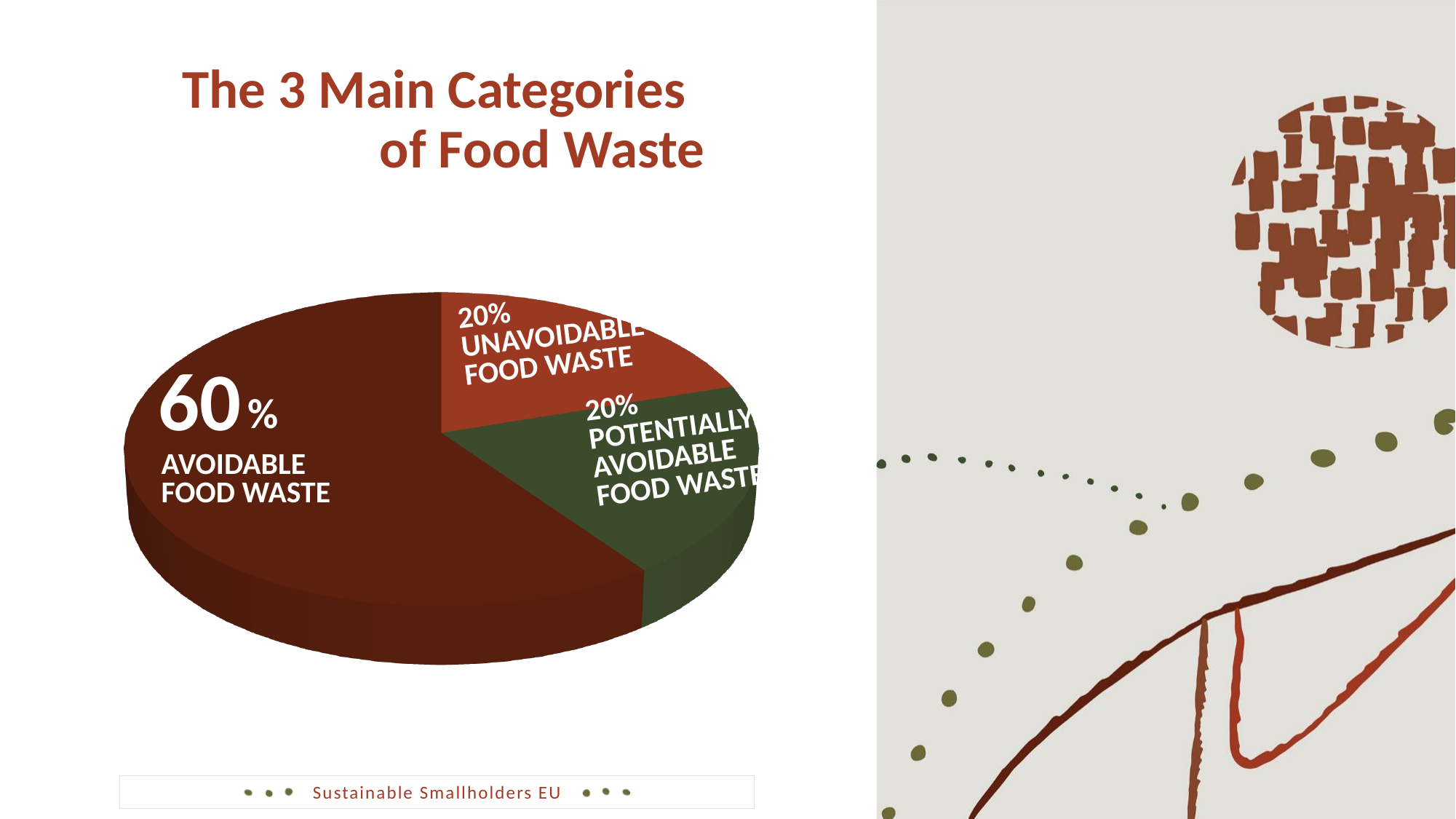
What is the title of the slide containing the pie chart? The 3 Main Categories of Food Waste What is the combined share of Unavoidable Food Waste and Potentially Avoidable Food Waste? 40% What colour is the slice for Potentially Avoidable Food Waste? dark green How many slices does the pie chart have? 3 What is the difference in percentage points between Avoidable Food Waste and Unavoidable Food Waste? 40 What share of the pie is Potentially Avoidable Food Waste? 20% What share of the pie is Unavoidable Food Waste? 20% What kind of chart is shown on the slide? pie chart Is the share for Avoidable Food Waste greater or less than 50%? greater Which is larger, the slice for Avoidable Food Waste or the slice for Potentially Avoidable Food Waste? Avoidable Food Waste What share of the pie is Avoidable Food Waste? 60% Which category has the largest slice of the pie? Avoidable Food Waste